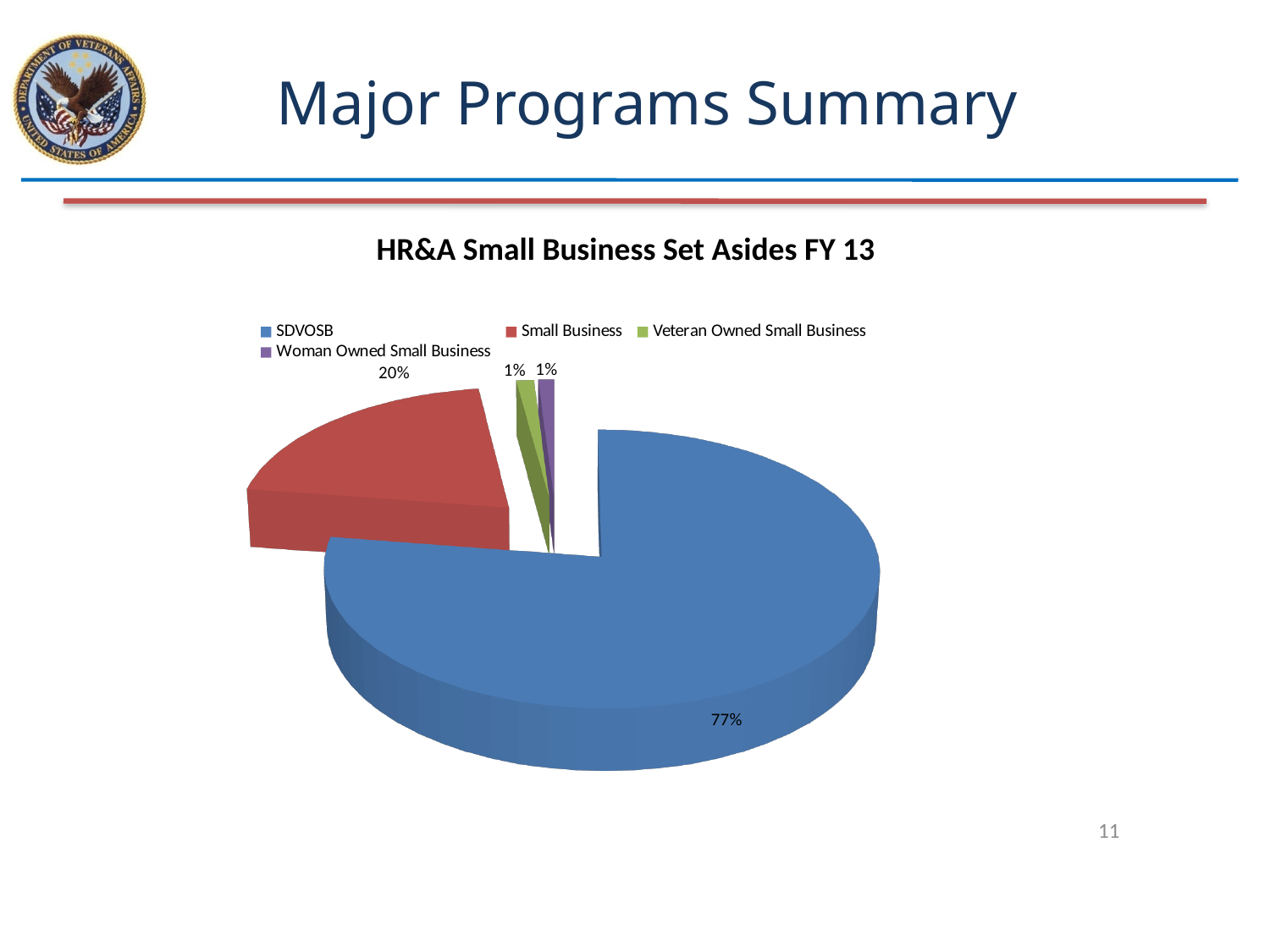
What colour is the SDVOSB slice? Blue How many entries does the legend list? 4 What share of the pie does Woman Owned Small Business represent? 1% What share of the pie does SDVOSB represent? 77% What is the title of the chart? HR&A Small Business Set Asides FY 13 How many slices does the pie chart have? 4 What kind of chart is shown on the slide? Pie chart What share of the pie does Veteran Owned Small Business represent? 1% Which category has the largest slice of the pie? SDVOSB Which is larger, the Small Business slice or the SDVOSB slice? SDVOSB How many percentage points larger is the SDVOSB slice than the Small Business slice? 57 percentage points